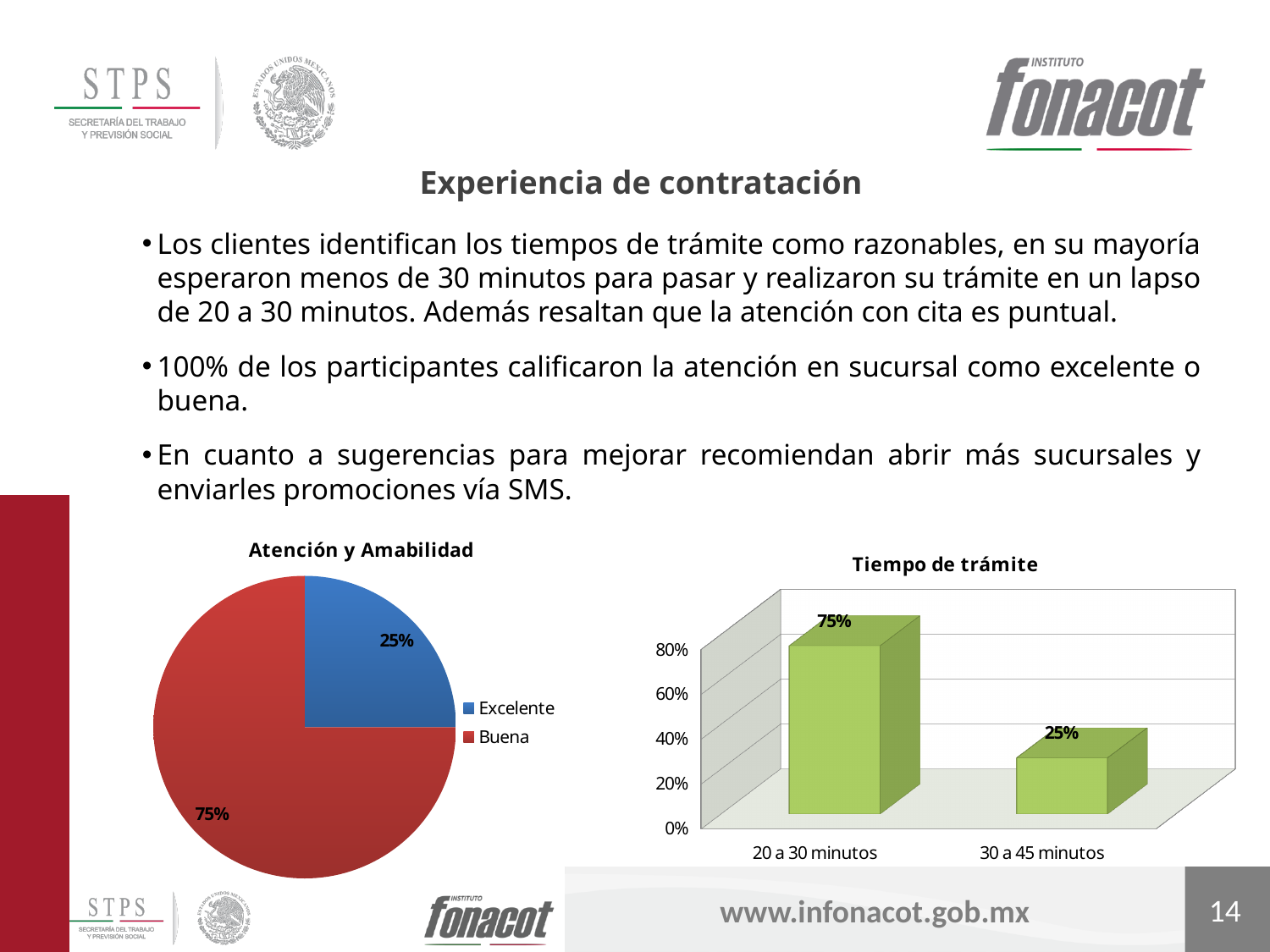
In the 'Atención y Amabilidad' chart, how many entries does the legend list? 2 In the 'Tiempo de trámite' chart, how many categories are shown on the x axis? 2 In the 'Tiempo de trámite' chart, which category has the lowest value? 30 a 45 minutos In the 'Atención y Amabilidad' chart, which category has the largest slice? Buena In the 'Atención y Amabilidad' chart, what colour is the 'Excelente' slice? Blue In the 'Tiempo de trámite' chart, what is the value for '30 a 45 minutos'? 25% In the 'Tiempo de trámite' chart, what is the value for '20 a 30 minutos'? 75% In the 'Atención y Amabilidad' chart, what share of the pie is 'Excelente'? 25% In the 'Tiempo de trámite' chart, what is the difference between '20 a 30 minutos' and '30 a 45 minutos'? 50% What kind of chart is 'Tiempo de trámite'? Bar chart In the 'Atención y Amabilidad' chart, what share of the pie is 'Buena'? 75% What kind of chart is 'Atención y Amabilidad'? Pie chart